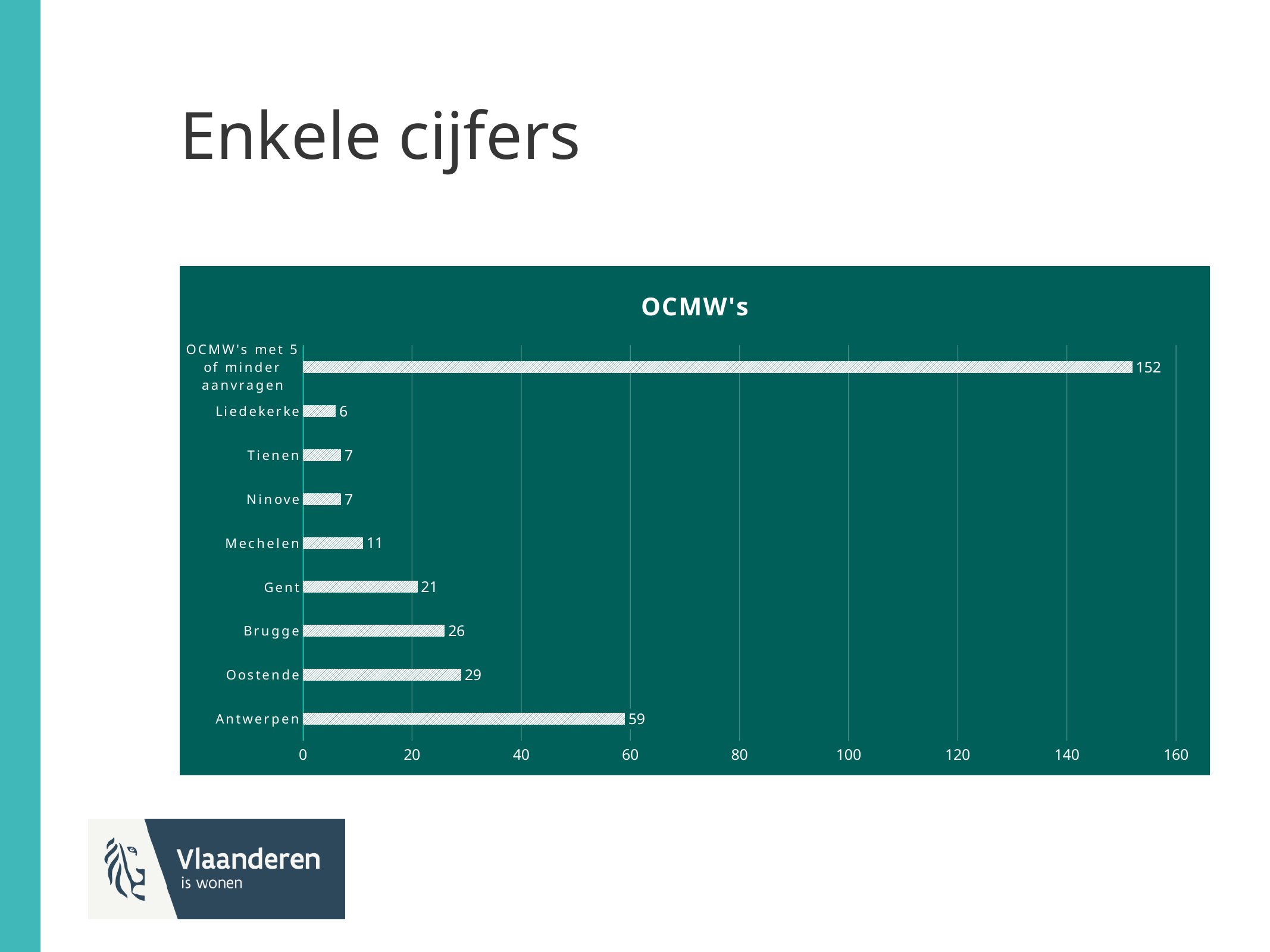
What kind of chart is shown? bar chart Which category has the highest value? OCMW's met 5 of minder aanvragen What is the title of the chart? OCMW's Which category has the lowest value? Liedekerke How many categories are shown in the chart? 9 What is the difference between the values for Antwerpen and Oostende? 30 What is the value for Oostende? 29 Is the value for Antwerpen greater or less than 40? greater What is the value for OCMW's met 5 of minder aanvragen? 152 What is the value for Mechelen? 11 Which is larger, the value for Brugge or the value for Gent? Brugge What is the value for Antwerpen? 59